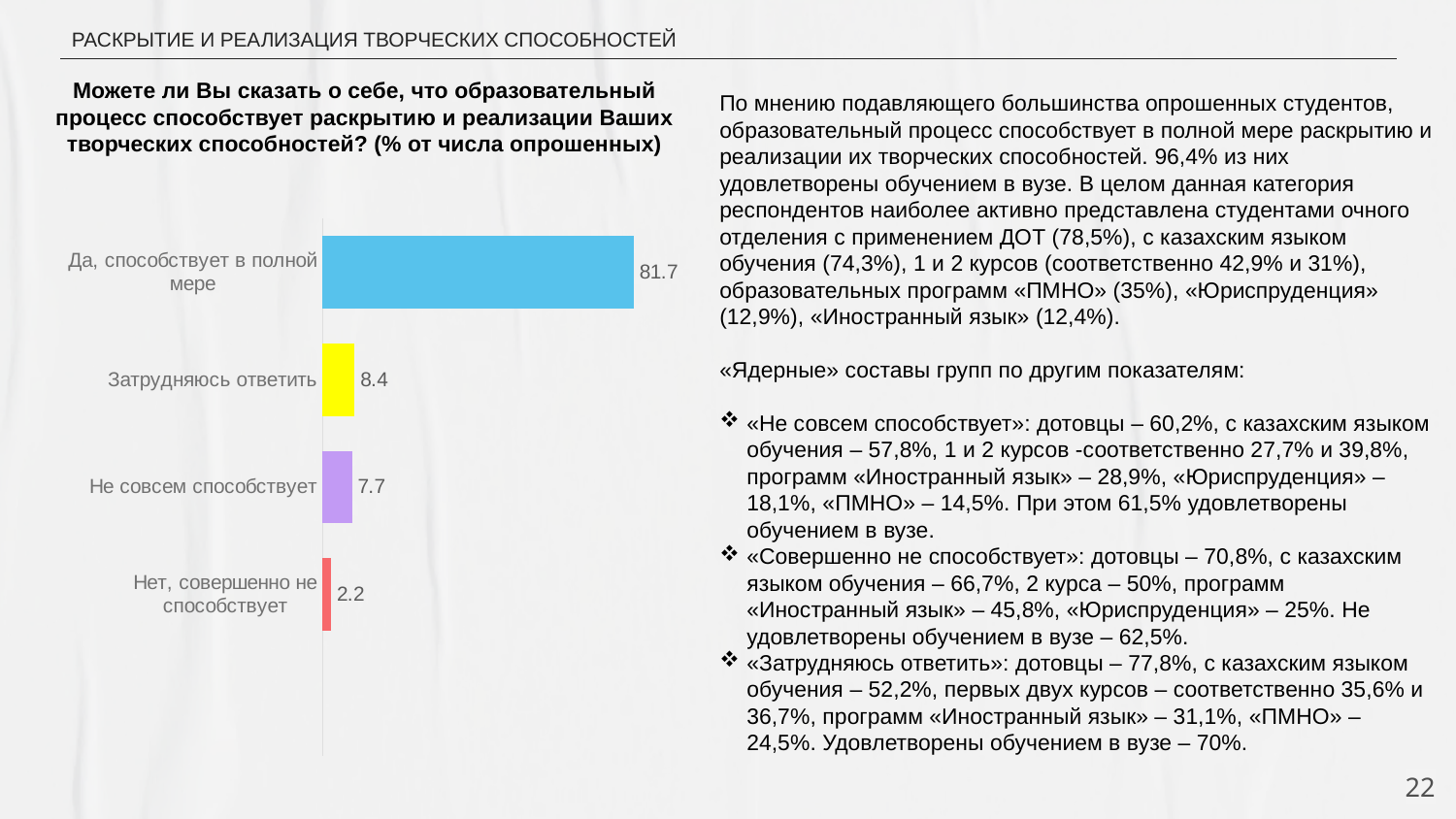
What colour is the bar for "Затрудняюсь ответить"? Yellow Which category has the lowest value? Нет, совершенно не способствует What is the value for "Да, способствует в полной мере"? 81.7 What kind of chart is shown on the slide? Bar chart What is the value for "Затрудняюсь ответить"? 8.4 What is the difference between the values for "Не совсем способствует" and "Нет, совершенно не способствует"? 5.5 What is the value for "Нет, совершенно не способствует"? 2.2 Which category has the highest value? Да, способствует в полной мере Which is larger: the value for "Затрудняюсь ответить" or the value for "Не совсем способствует"? Затрудняюсь ответить What is the difference between the values for "Да, способствует в полной мере" and "Затрудняюсь ответить"? 73.3 What is the value for "Не совсем способствует"? 7.7 How many categories are shown in the chart? 4